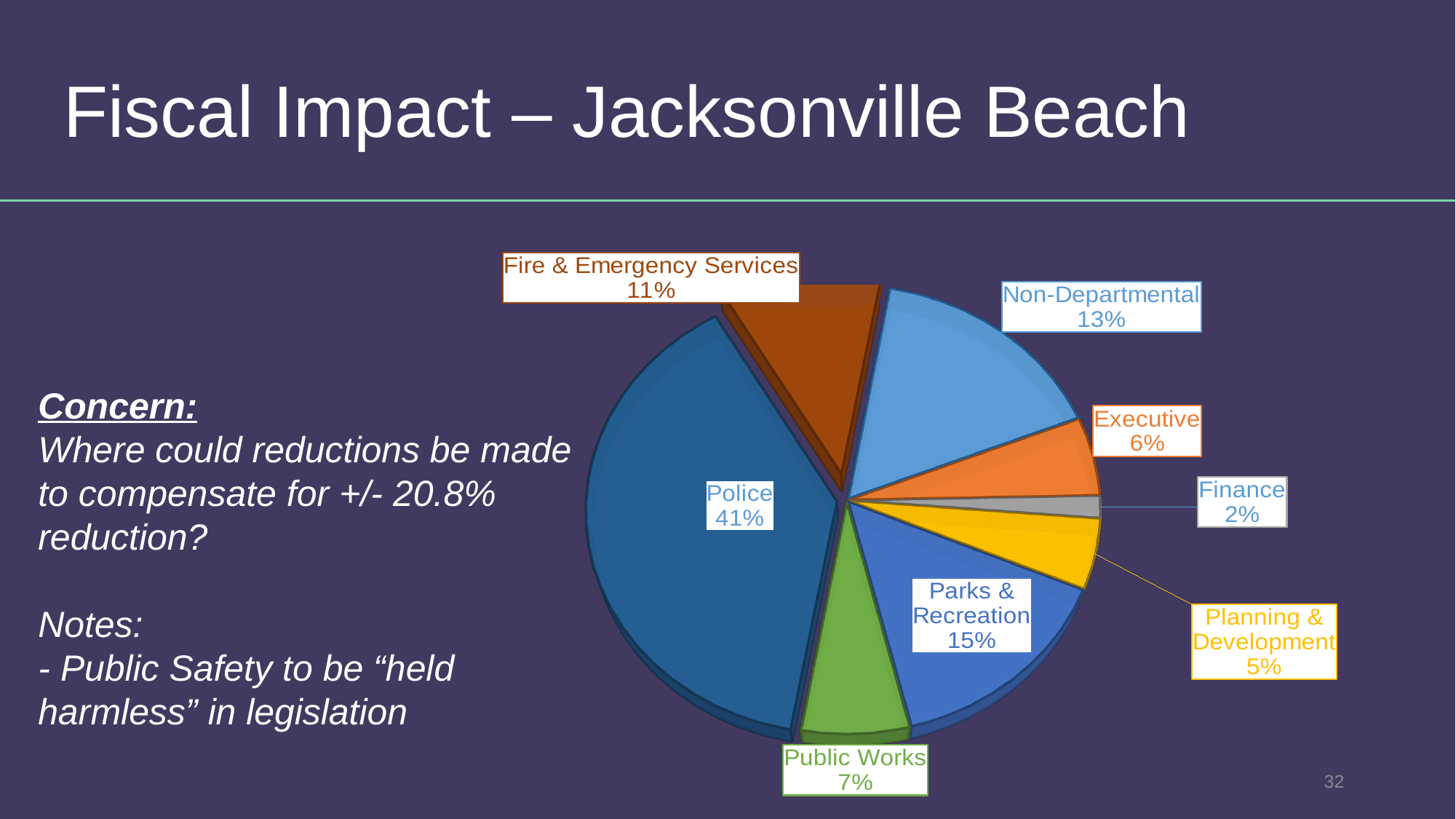
Which is larger, Public Works or Planning & Development? Public Works What kind of chart is shown on the slide? Pie chart How many categories are shown in the pie chart? 8 What share of the pie does Police represent? 41% What percentage is shown for Fire & Emergency Services? 11% What is the combined share of Police and Fire & Emergency Services? 52% Which category has the largest slice of the pie? Police What percentage is shown for Finance? 2% What is the difference in percentage points between Non-Departmental and Executive? 7 What is the difference in percentage points between Police and Parks & Recreation? 26 What percentage is shown for Parks & Recreation? 15% Which category has the smallest slice of the pie? Finance